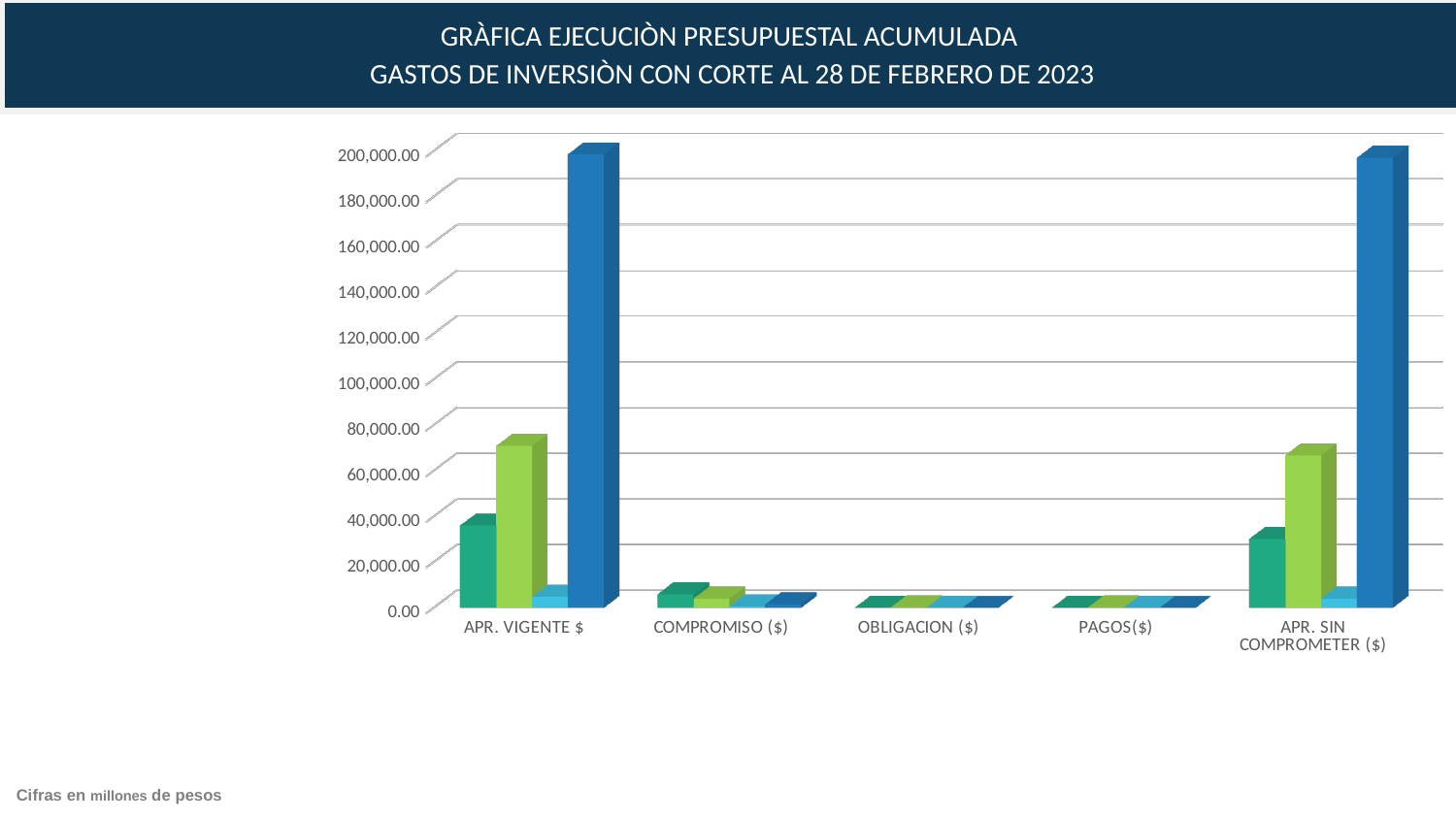
Is the value of the green bar for APR. SIN COMPROMETER ($) greater or less than 80,000.00? less Is the value of the dark blue bar for APR. VIGENTE $ greater or less than 180,000.00? greater How many bars are plotted for each category in the chart? 4 How many categories are shown on the x axis of the chart? 5 Is the value of the dark blue bar for APR. SIN COMPROMETER ($) greater or less than 160,000.00? greater What kind of chart is shown on the slide? bar chart According to the note at the bottom of the slide, in what units are the figures expressed? millones de pesos Which has the larger dark blue bar, APR. VIGENTE $ or COMPROMISO ($)? APR. VIGENTE $ Which has the larger teal bar, COMPROMISO ($) or OBLIGACION ($)? COMPROMISO ($)